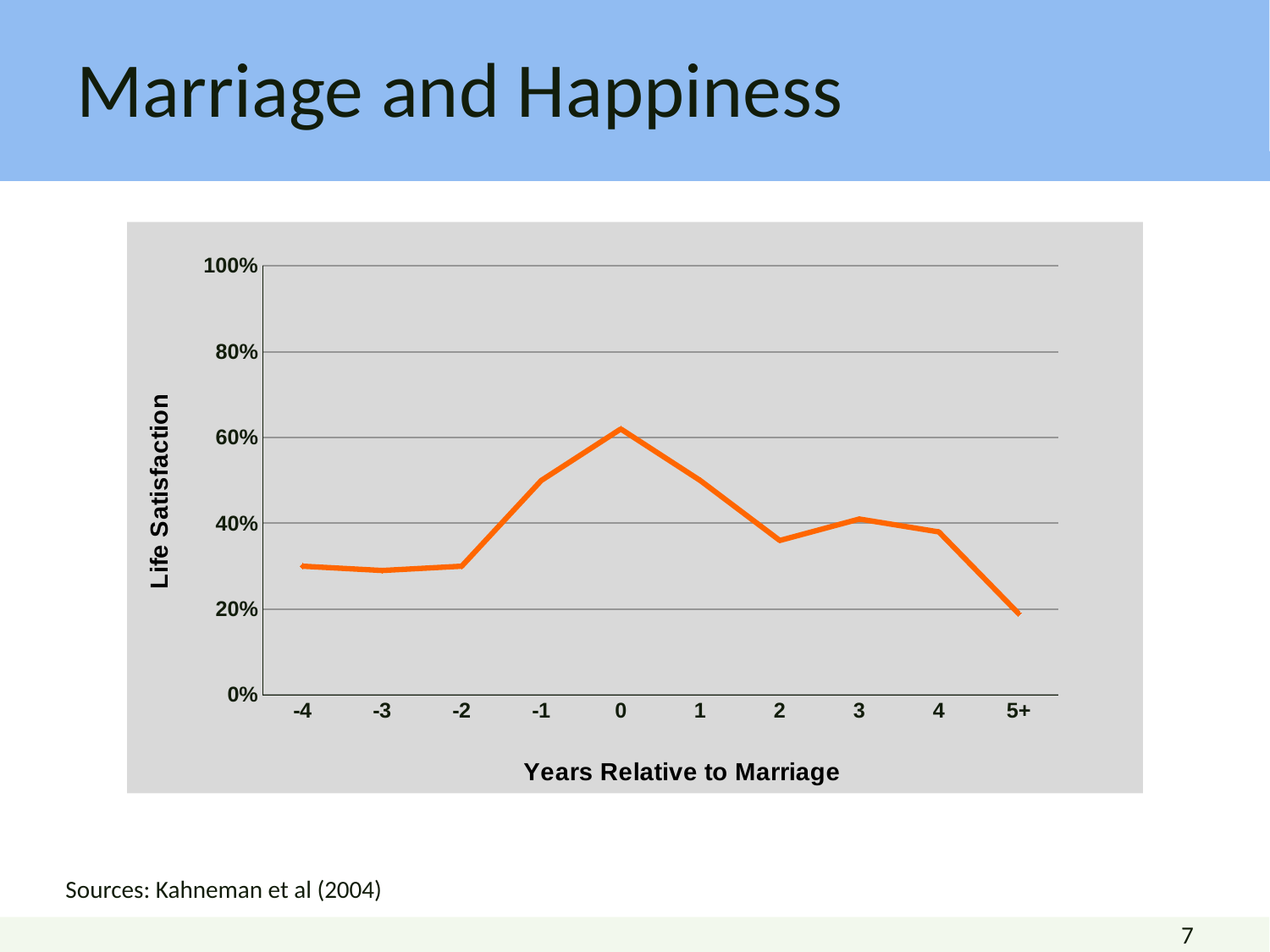
Is life satisfaction at year -1 greater or less than 40%? greater Is life satisfaction at year 5+ greater or less than 40%? less What is the title of the x axis? Years Relative to Marriage Is life satisfaction at year 0 greater or less than 40%? greater Does life satisfaction rise or fall from year -2 to year 0? rise Does life satisfaction rise or fall from year 0 to year 5+? fall At which year relative to marriage is life satisfaction lowest? 5+ How many points are plotted along the x axis? 10 At which year relative to marriage is life satisfaction highest? 0 Which has higher life satisfaction, year -1 or year 2? -1 What kind of chart is shown on the slide? line chart